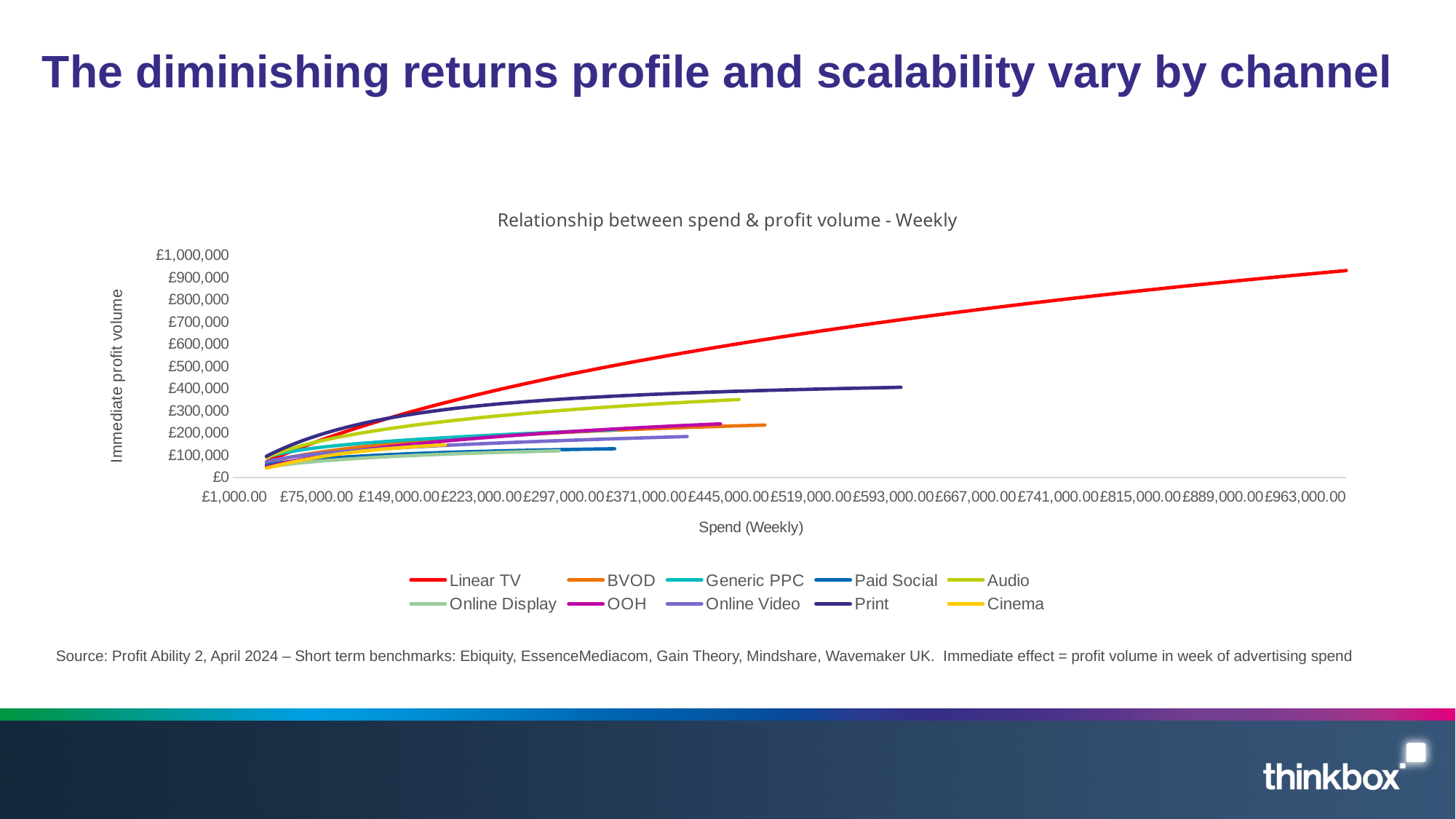
Is the highest profit volume reached by the Linear TV line greater or less than £800,000? greater At their endpoints, which line reaches a higher profit volume: Online Video or Paid Social? Online Video What is the label on the vertical axis of the chart? Immediate profit volume Which series extends furthest to the right along the Spend (Weekly) axis? Linear TV Does the Linear TV line rise or fall as weekly spend increases? Rises Which series reaches the highest immediate profit volume on the chart? Linear TV Is the highest profit volume reached by the Print line greater or less than £300,000? greater How many series does the chart legend list? 10 At their endpoints, which line reaches a higher profit volume: Print or Audio? Print What kind of chart is shown on the slide? Line chart Is the highest profit volume reached by the Paid Social line greater or less than £200,000? less What is the title of the chart? Relationship between spend & profit volume - Weekly